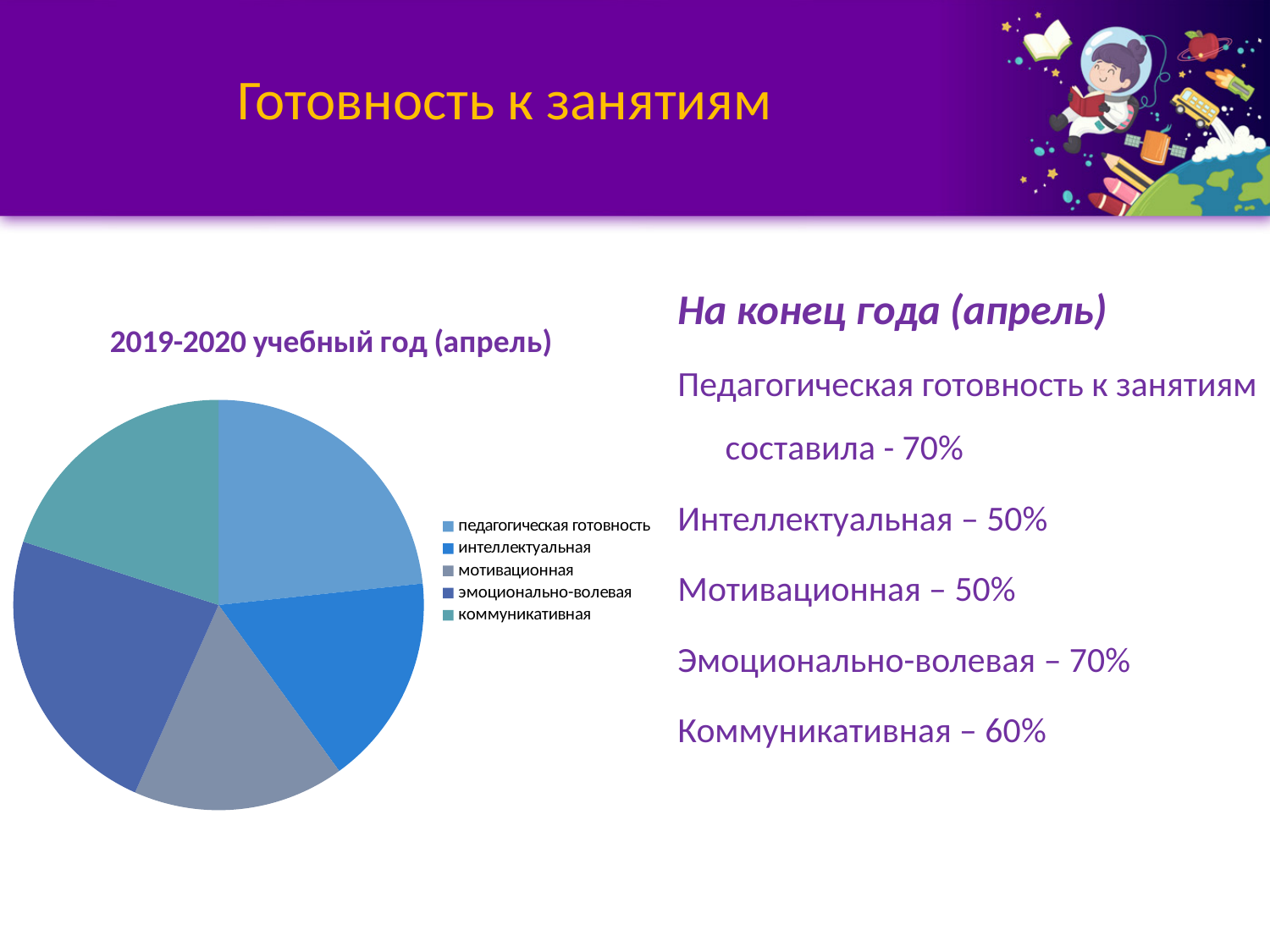
Which legend entry is listed first in the pie chart's legend? педагогическая готовность According to the slide, what is the value for интеллектуальная готовность? 50% How many slices does the pie chart have? 5 According to the slide, what is the value for коммуникативная готовность? 60% According to the slide, what is the value for эмоционально-волевая готовность? 70% What kind of chart is shown on the slide? pie chart What is the title of the pie chart? 2019-2020 учебный год (апрель) Which slice is larger in the pie chart: педагогическая готовность or интеллектуальная? педагогическая готовность What is the difference between the values for педагогическая готовность and интеллектуальная given on the slide? 20% How many entries does the legend of the pie chart list? 5 According to the slide, what is the value for педагогическая готовность? 70% Which slice is larger in the pie chart: эмоционально-волевая or мотивационная? эмоционально-волевая